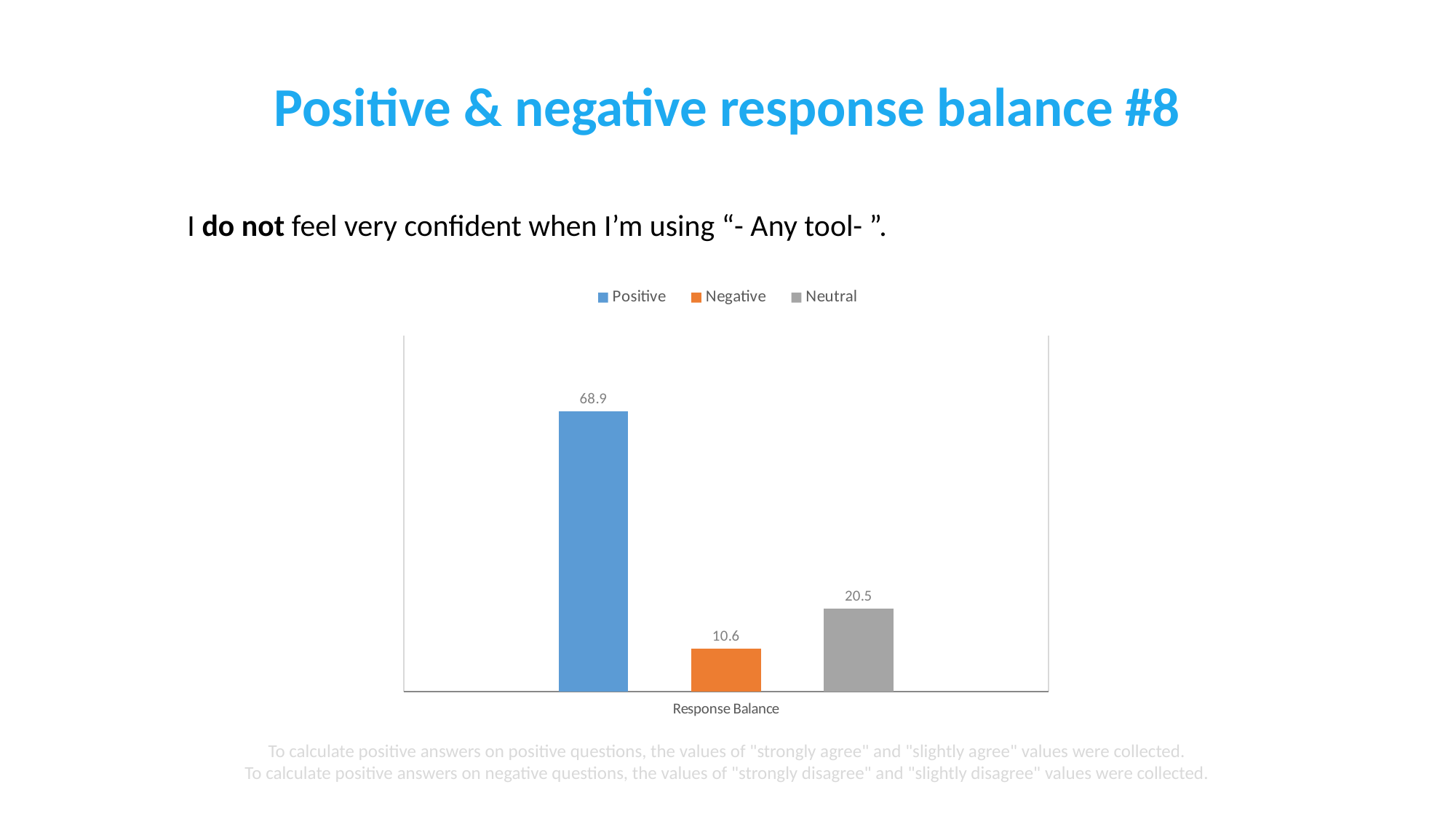
Which series has the highest value in the chart? Positive What is the difference between the Neutral and Negative values? 9.9 How many series does the legend list? 3 What is the difference between the Positive and Negative values? 58.3 What is the value of the Neutral series in the Response Balance chart? 20.5 What colour is the Negative bar in the chart? Orange Which series has the lowest value in the chart? Negative What kind of chart is shown on the slide? Bar chart What is the value of the Negative series in the Response Balance chart? 10.6 What is the category label shown on the x axis of the chart? Response Balance What is the value of the Positive series in the Response Balance chart? 68.9 Which is larger, the Neutral value or the Negative value? Neutral